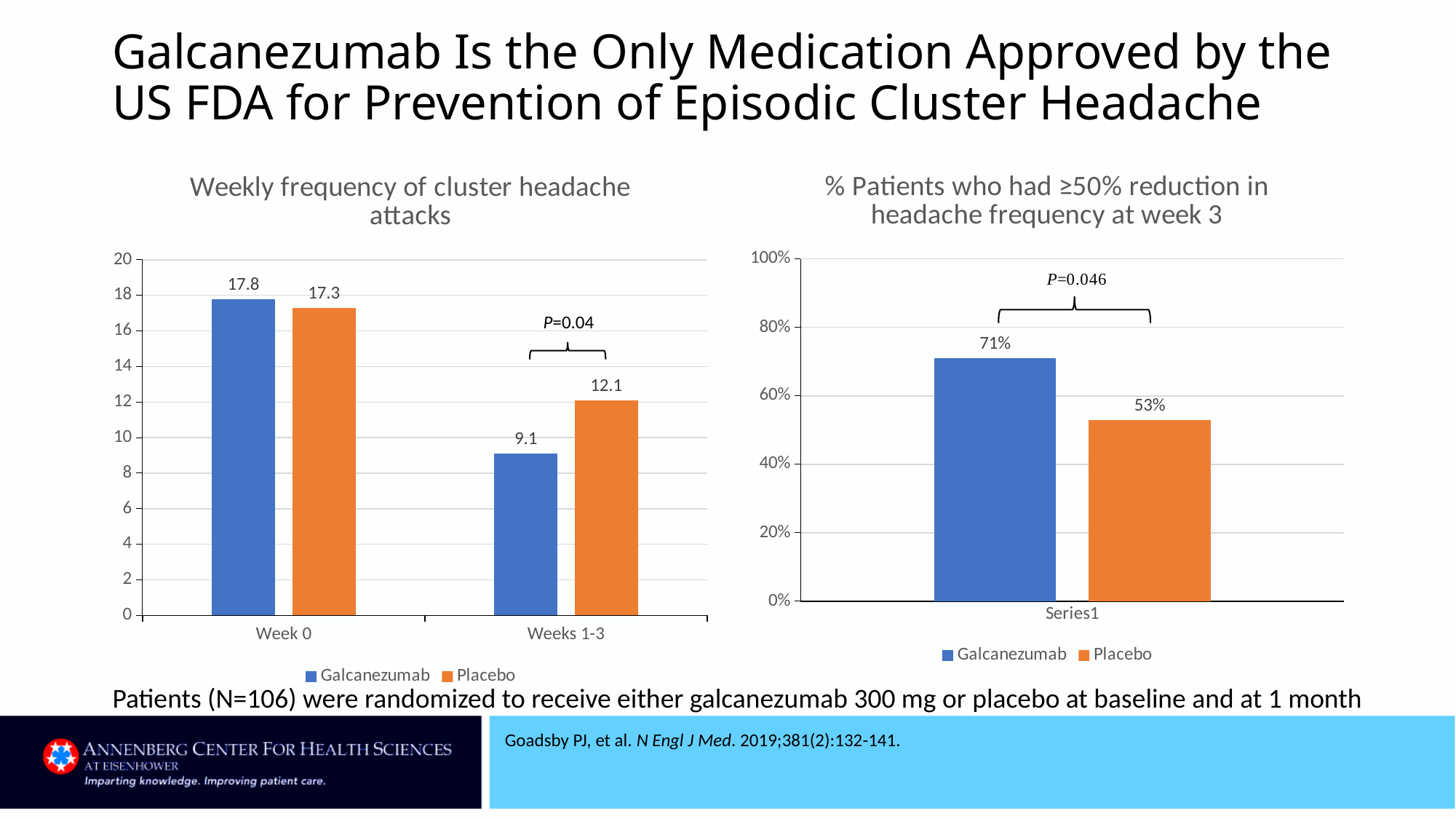
In the '% Patients who had ≥50% reduction in headache frequency at week 3' chart, what is the value for Galcanezumab? 71% In the 'Weekly frequency of cluster headache attacks' chart, how many categories are shown on the x axis? 2 In the 'Weekly frequency of cluster headache attacks' chart, which bar has the highest value? Galcanezumab at Week 0 In the '% Patients who had ≥50% reduction in headache frequency at week 3' chart, what is the difference between Galcanezumab and Placebo? 18% In the 'Weekly frequency of cluster headache attacks' chart, which is larger at Weeks 1-3, Galcanezumab or Placebo? Placebo In the 'Weekly frequency of cluster headache attacks' chart, does the Galcanezumab value rise or fall from Week 0 to Weeks 1-3? Fall In the '% Patients who had ≥50% reduction in headache frequency at week 3' chart, what is the value for Placebo? 53% In the 'Weekly frequency of cluster headache attacks' chart, what is the difference between Placebo and Galcanezumab at Weeks 1-3? 3.0 How many series does the legend list in the '% Patients who had ≥50% reduction in headache frequency at week 3' chart? 2 What type of chart is the 'Weekly frequency of cluster headache attacks' chart? Bar chart In the 'Weekly frequency of cluster headache attacks' chart, what is the value for Galcanezumab at Weeks 1-3? 9.1 In the 'Weekly frequency of cluster headache attacks' chart, what is the value for Placebo at Week 0? 17.3